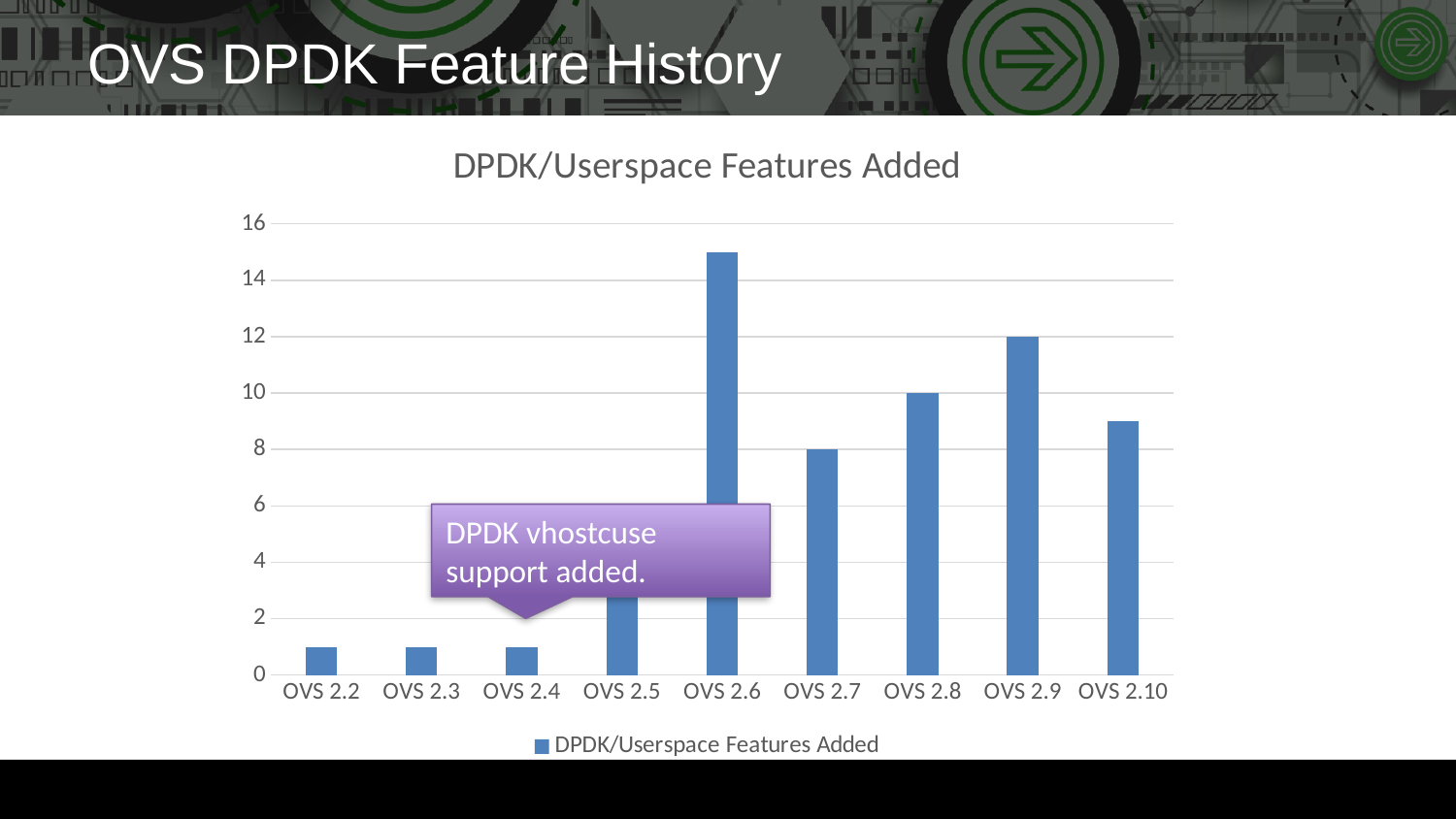
What is the title of the chart? DPDK/Userspace Features Added Is the value for OVS 2.2 greater or less than 2? less How many OVS versions are shown on the x axis of the chart? 9 Is the value for OVS 2.6 greater or less than 14? greater Which OVS version has the highest number of DPDK/Userspace features added? OVS 2.6 How many DPDK/Userspace features were added in OVS 2.7? 8 What is the difference between the number of features added in OVS 2.9 and in OVS 2.7? 4 What type of chart is shown on the slide? Bar chart How many series does the chart's legend list? 1 Which has more DPDK/Userspace features added, OVS 2.9 or OVS 2.8? OVS 2.9 How many DPDK/Userspace features were added in OVS 2.9? 12 How many DPDK/Userspace features were added in OVS 2.8? 10